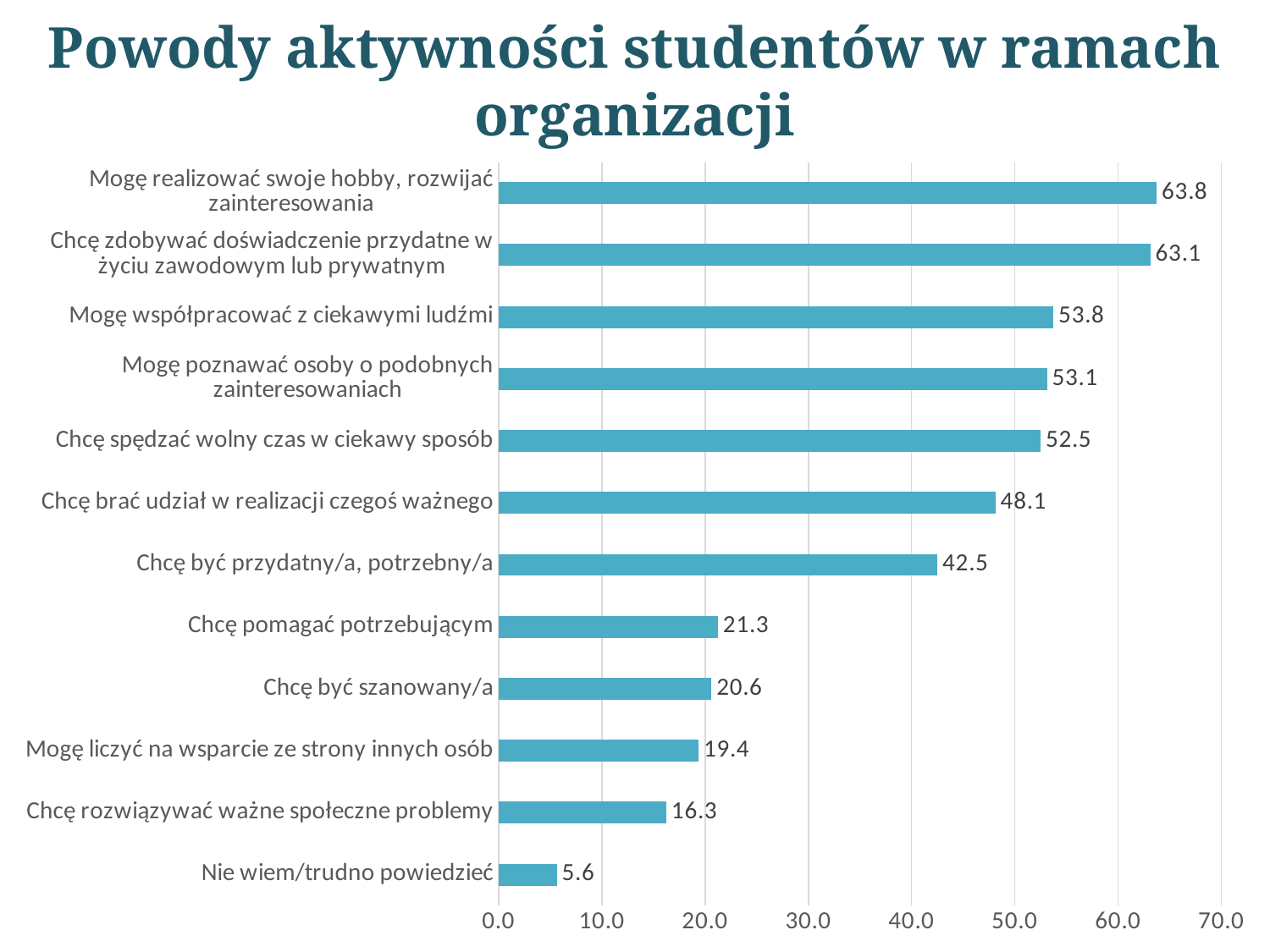
What is the title of the chart? Powody aktywności studentów w ramach organizacji Is the value for "Chcę rozwiązywać ważne społeczne problemy" greater or less than 20.0? less What is the difference between the values for "Chcę brać udział w realizacji czegoś ważnego" and "Chcę być przydatny/a, potrzebny/a"? 5.6 Which is larger: the value for "Chcę być szanowany/a" or the value for "Mogę liczyć na wsparcie ze strony innych osób"? Chcę być szanowany/a Which category has the lowest value? Nie wiem/trudno powiedzieć Which category has the highest value? Mogę realizować swoje hobby, rozwijać zainteresowania What is the value for "Mogę współpracować z ciekawymi ludźmi"? 53.8 What is the value for "Nie wiem/trudno powiedzieć"? 5.6 What kind of chart is shown on the slide? bar chart What is the difference between the values for "Mogę realizować swoje hobby, rozwijać zainteresowania" and "Chcę zdobywać doświadczenie przydatne w życiu zawodowym lub prywatnym"? 0.7 What is the value for "Chcę pomagać potrzebującym"? 21.3 How many categories are shown in the chart? 12